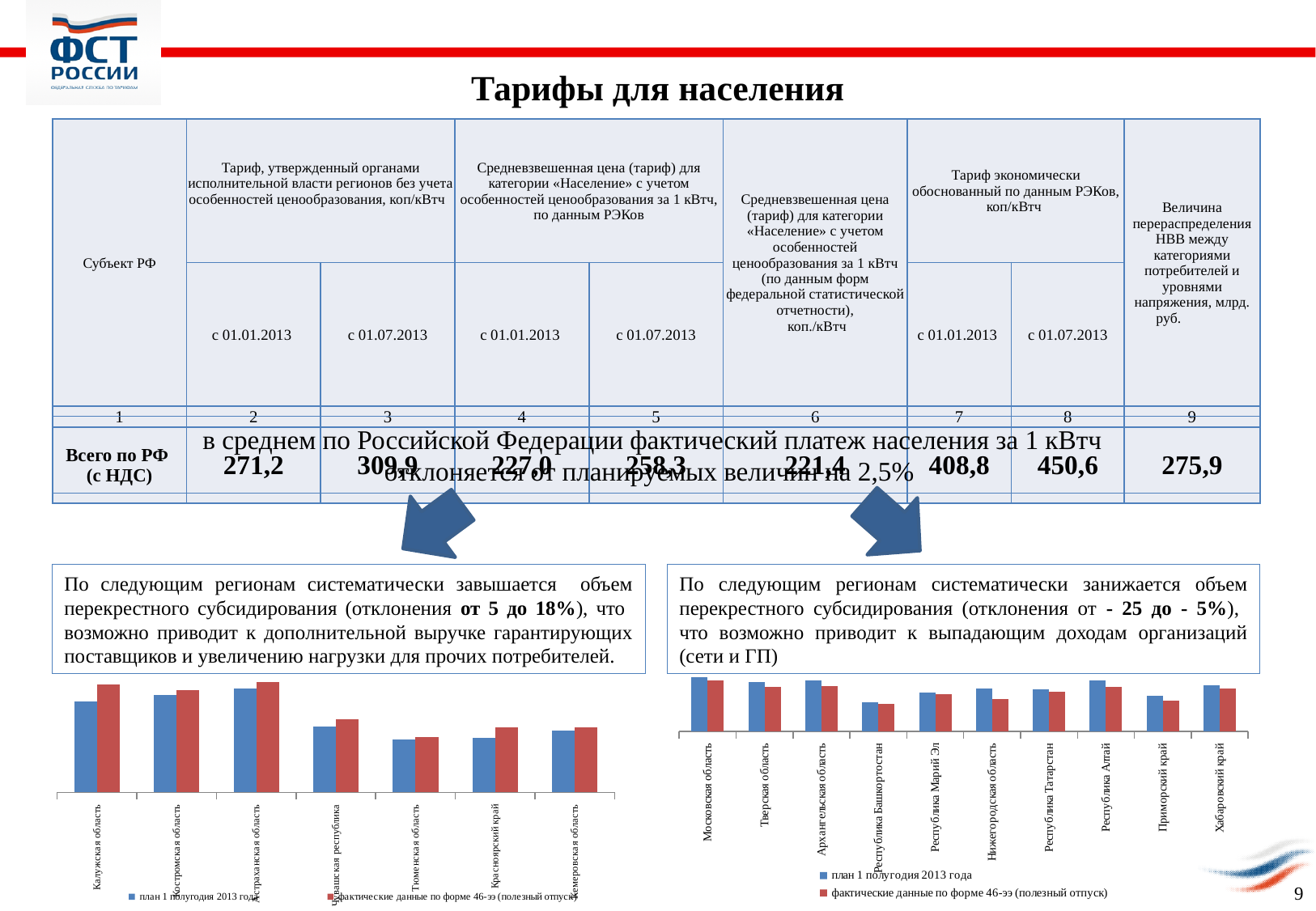
In the right chart, which region has the shortest bars? Республика Башкортостан In the left chart, for Калужская область, which series is larger: план 1 полугодия 2013 года or фактические данные по форме 46-ээ (полезный отпуск)? фактические данные по форме 46-ээ (полезный отпуск) What kind of chart is the left chart at the bottom of the slide? bar chart What kind of chart is the right chart at the bottom of the slide? bar chart How many series does the legend of the right chart list? 2 How many series does the legend of the left chart list? 2 In the left chart, which region has the shortest bar? Тюменская область In the right chart, for Республика Алтай, which series is larger: план 1 полугодия 2013 года or фактические данные по форме 46-ээ (полезный отпуск)? план 1 полугодия 2013 года How many regions are shown on the x axis of the left chart? 7 In the left chart, which region has the tallest bar? Астраханская область How many regions are shown on the x axis of the right chart? 10 In the right chart, which colour represents the series план 1 полугодия 2013 года? blue